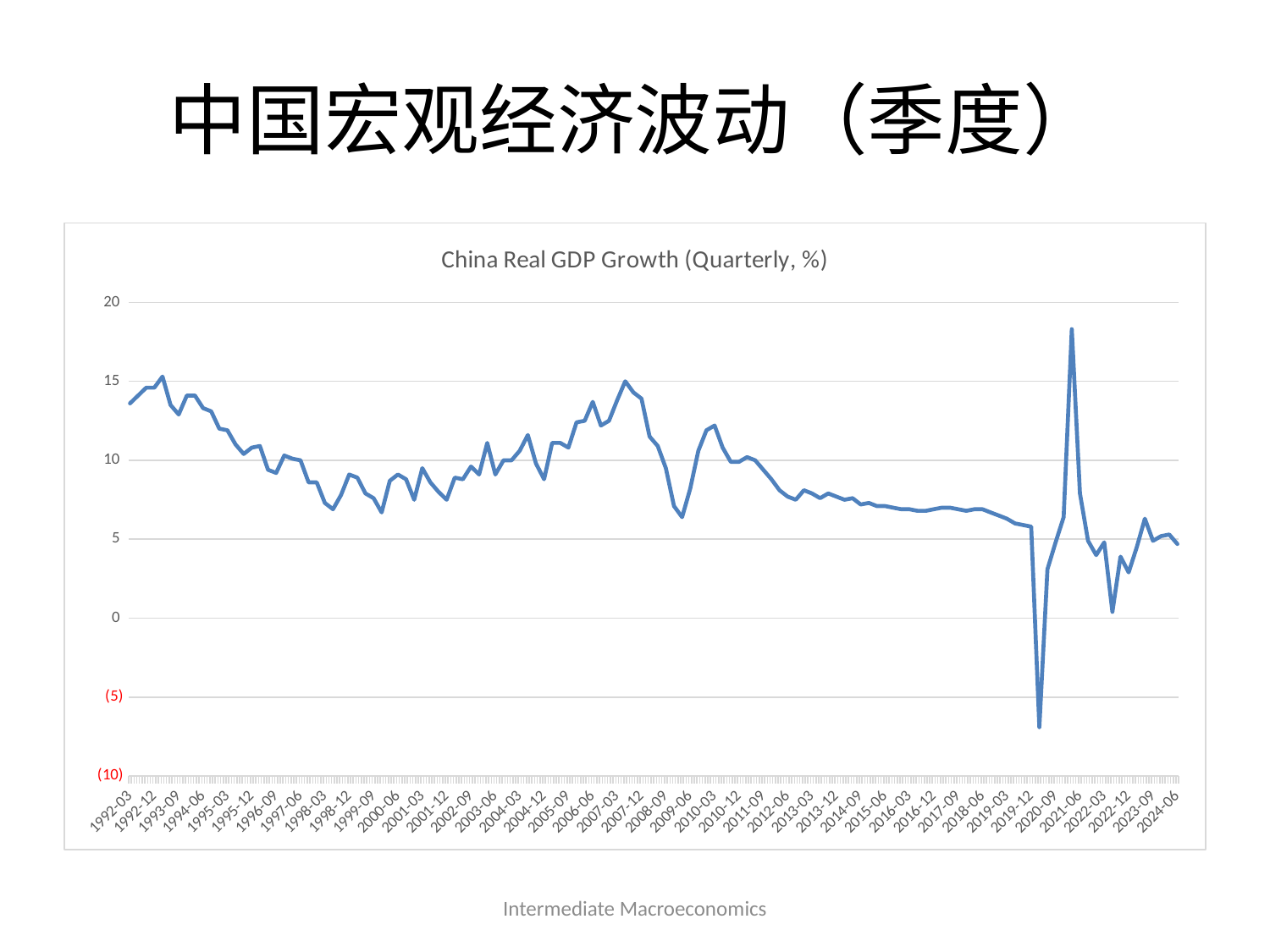
What is the lowest value shown on the vertical axis? (10) Is the value for 2019-12 greater or less than 10? less Is the value for 2009-06 greater or less than 10? less In which year does the line reach its highest point? 2021 In which year does the line reach its lowest point? 2020 Is the value for 2007-03 greater or less than 10? greater What is the title of the chart? China Real GDP Growth (Quarterly, %) From 2010-03 to 2019-03, does the line generally rise or fall? fall What kind of chart is shown on the slide? line chart How many lines (data series) are plotted on the chart? 1